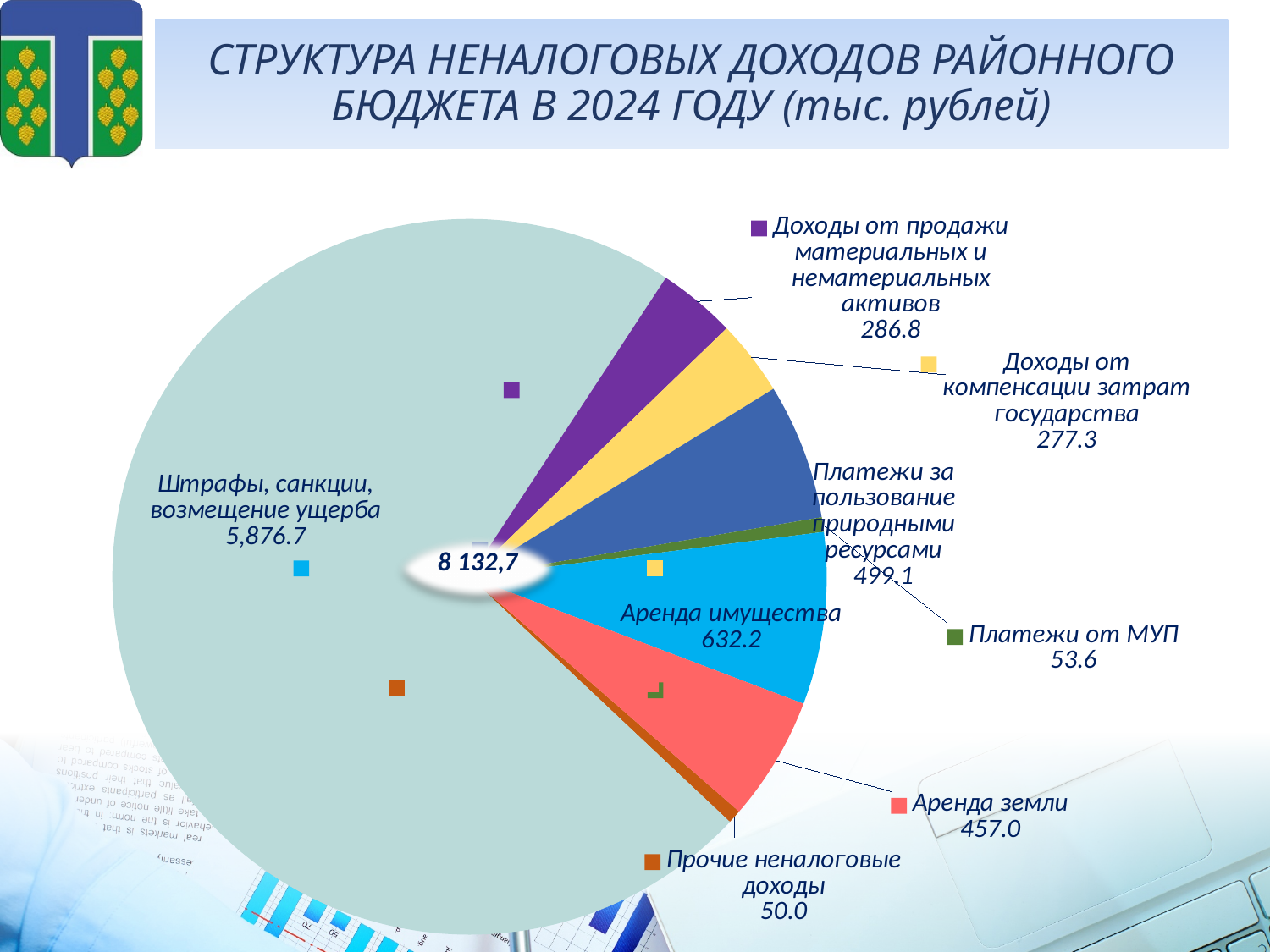
What is the difference between Аренда имущества and Аренда земли? 175.2 How many categories does the pie chart show? 8 What is the value for Доходы от компенсации затрат государства? 277.3 What kind of chart is shown on the slide? pie chart Which is larger, Аренда имущества or Аренда земли? Аренда имущества What total value is shown in the centre of the pie chart? 8 132,7 Which category has the smallest value? Прочие неналоговые доходы What is the value for Аренда имущества? 632.2 What is the value for Штрафы, санкции, возмещение ущерба? 5,876.7 What is the difference between Платежи от МУП and Прочие неналоговые доходы? 3.6 Which category has the largest slice of the pie? Штрафы, санкции, возмещение ущерба What is the value for Платежи за пользование природными ресурсами? 499.1